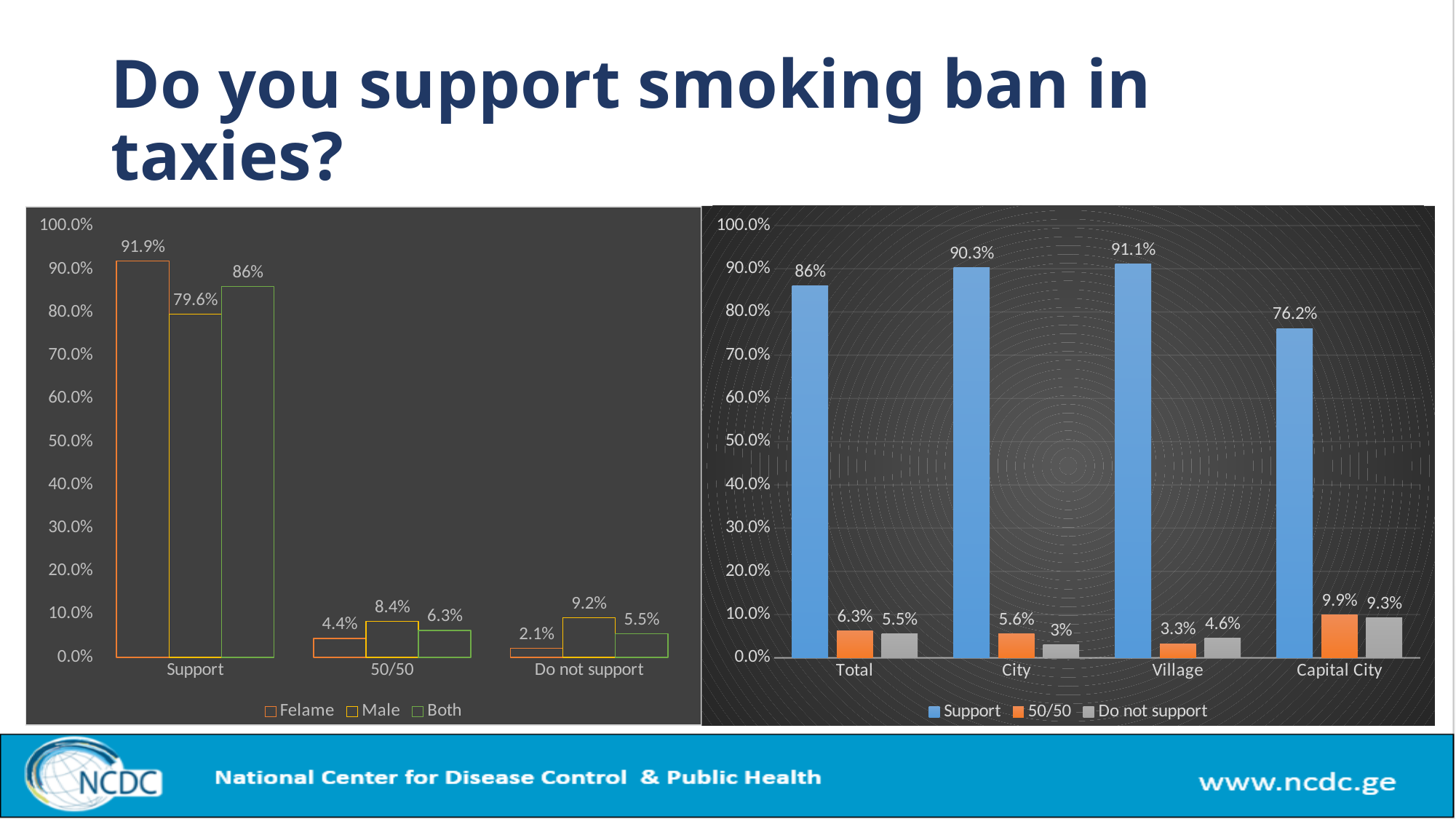
In the left chart, how many series does the legend list? 3 In the right chart, which category has the highest Support value? Village In the right chart, which category has the lowest Support value? Capital City In the left chart, which series has the lowest value in the 50/50 category? Felame What type of chart is the right chart? bar chart In the left chart, what is the value for Male in the Do not support category? 9.2% In the left chart, what is the value for Felame in the Support category? 91.9% In the left chart, what is the difference between the Felame and Male values in the Support category? 12.3% In the right chart, how many categories are shown on the x axis? 4 In the right chart, what is the Support value for Village? 91.1% In the right chart, what is the 50/50 value for Capital City? 9.9% In the right chart, is the Do not support value for City larger or smaller than the Do not support value for Capital City? smaller